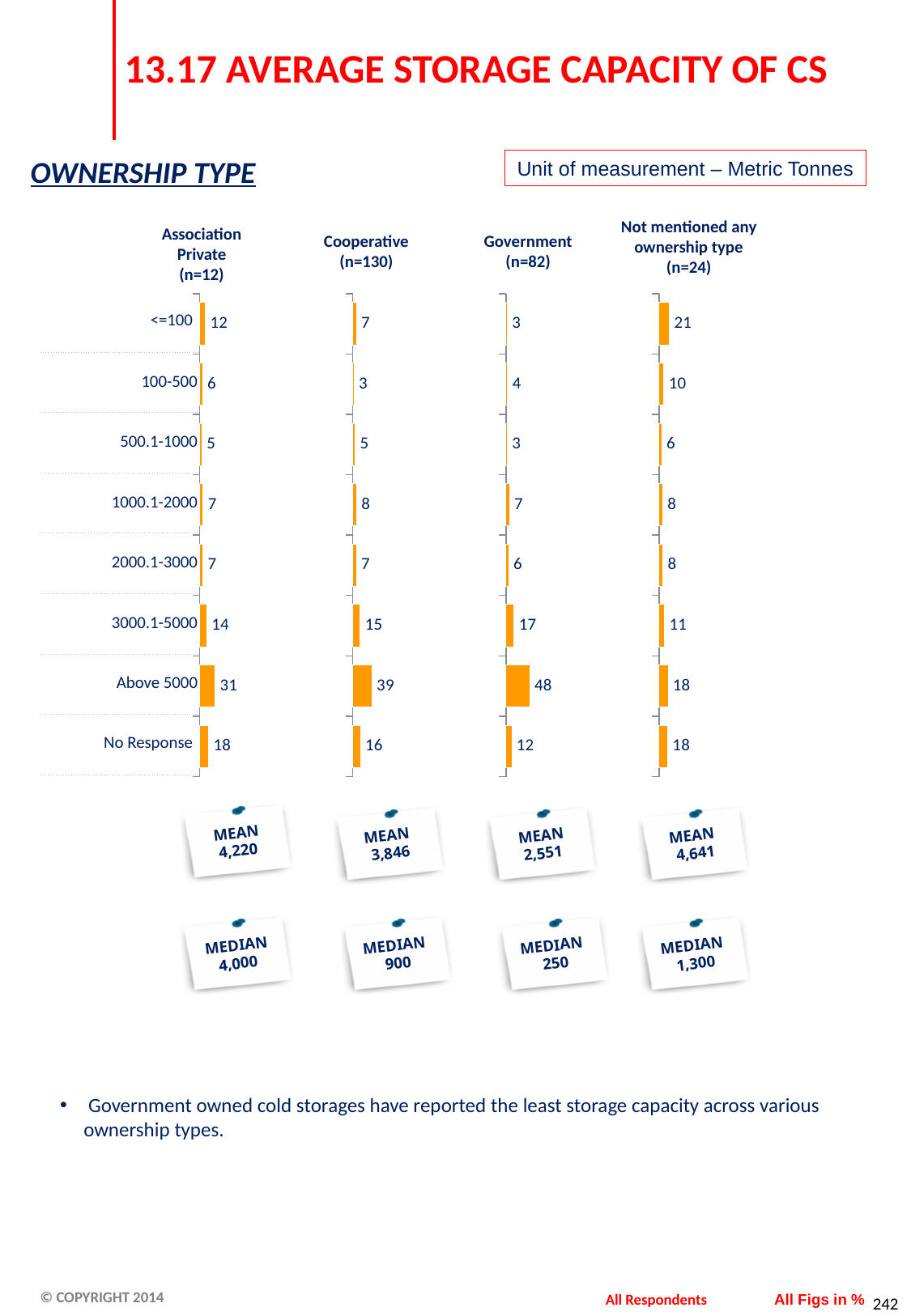
In the Not mentioned any ownership type (n=24) chart, which category has the highest value? <=100 How many capacity categories are shown in each chart? 8 In the Government (n=82) chart, what is the value for Above 5000? 48 In the Association Private (n=12) chart, what is the value for 3000.1-5000? 14 What is the mean storage capacity shown for the Government (n=82) ownership type? 2,551 In the Association Private (n=12) chart, what is the value for <=100? 12 In the Cooperative (n=130) chart, what is the value for No Response? 16 What type of chart is used to show the storage capacity distribution by ownership type? Bar chart In the Cooperative (n=130) chart, which category has the lowest value? 100-500 What is the median storage capacity shown for the Cooperative (n=130) ownership type? 900 Which is larger: the Above 5000 value in the Cooperative (n=130) chart or the Above 5000 value in the Association Private (n=12) chart? Cooperative (n=130) In the Government (n=82) chart, what is the difference between the values for Above 5000 and 3000.1-5000? 31